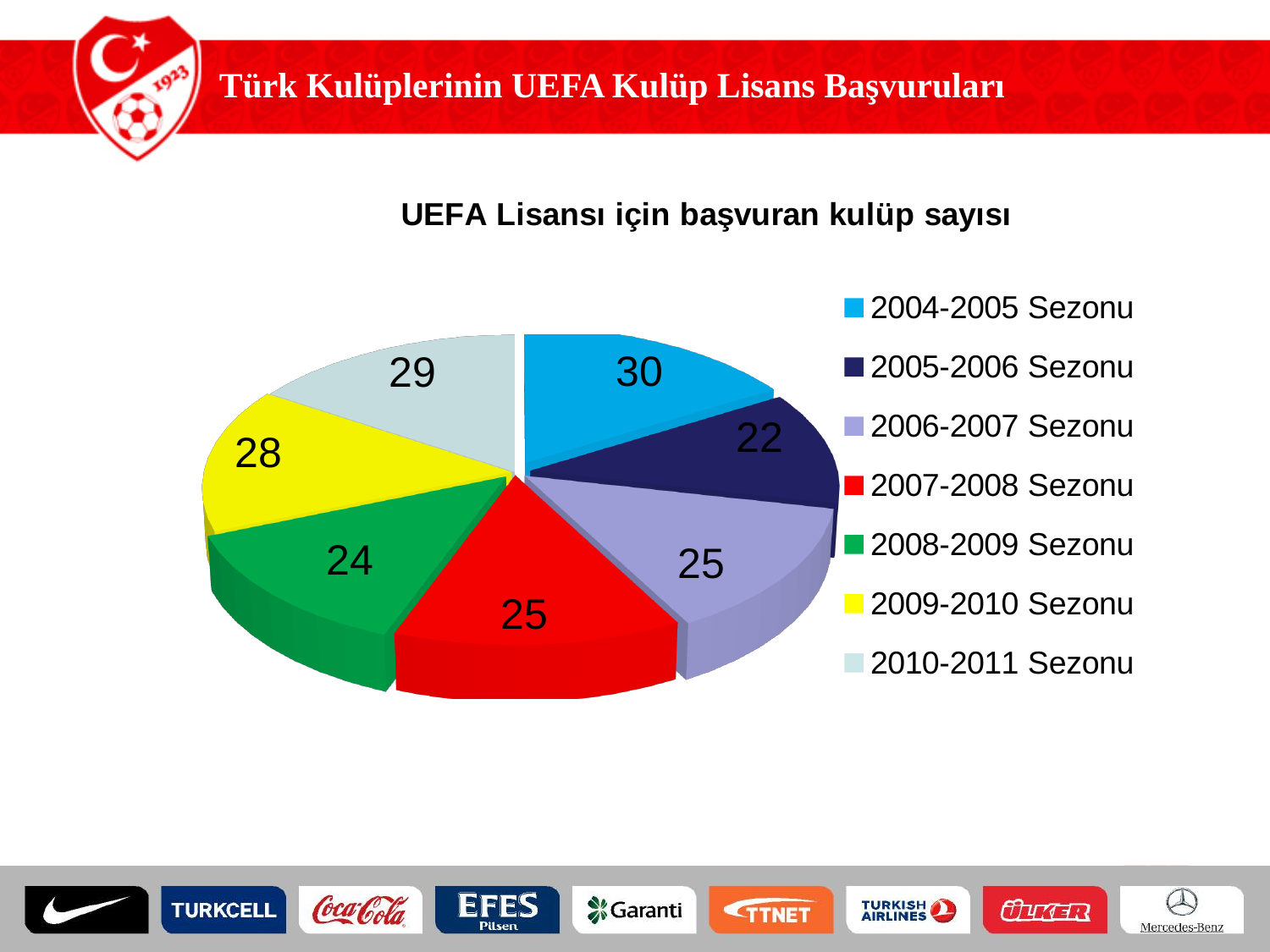
What is the title of the chart? UEFA Lisansı için başvuran kulüp sayısı Which season has the smallest slice in the pie chart? 2005-2006 Sezonu What is the value for the 2010-2011 Sezonu slice? 29 How many seasons (slices) does the pie chart show? 7 What is the value for the 2005-2006 Sezonu slice? 22 How many clubs applied for a UEFA licence in the 2004-2005 Sezonu? 30 Which is larger, the value for the 2008-2009 Sezonu or the 2009-2010 Sezonu? 2009-2010 Sezonu What is the value for the 2009-2010 Sezonu slice? 28 What colour is the slice for the 2007-2008 Sezonu? Red Which season has the largest slice in the pie chart? 2004-2005 Sezonu What is the difference between the values for the 2004-2005 Sezonu and the 2005-2006 Sezonu? 8 What type of chart is shown on the slide? Pie chart